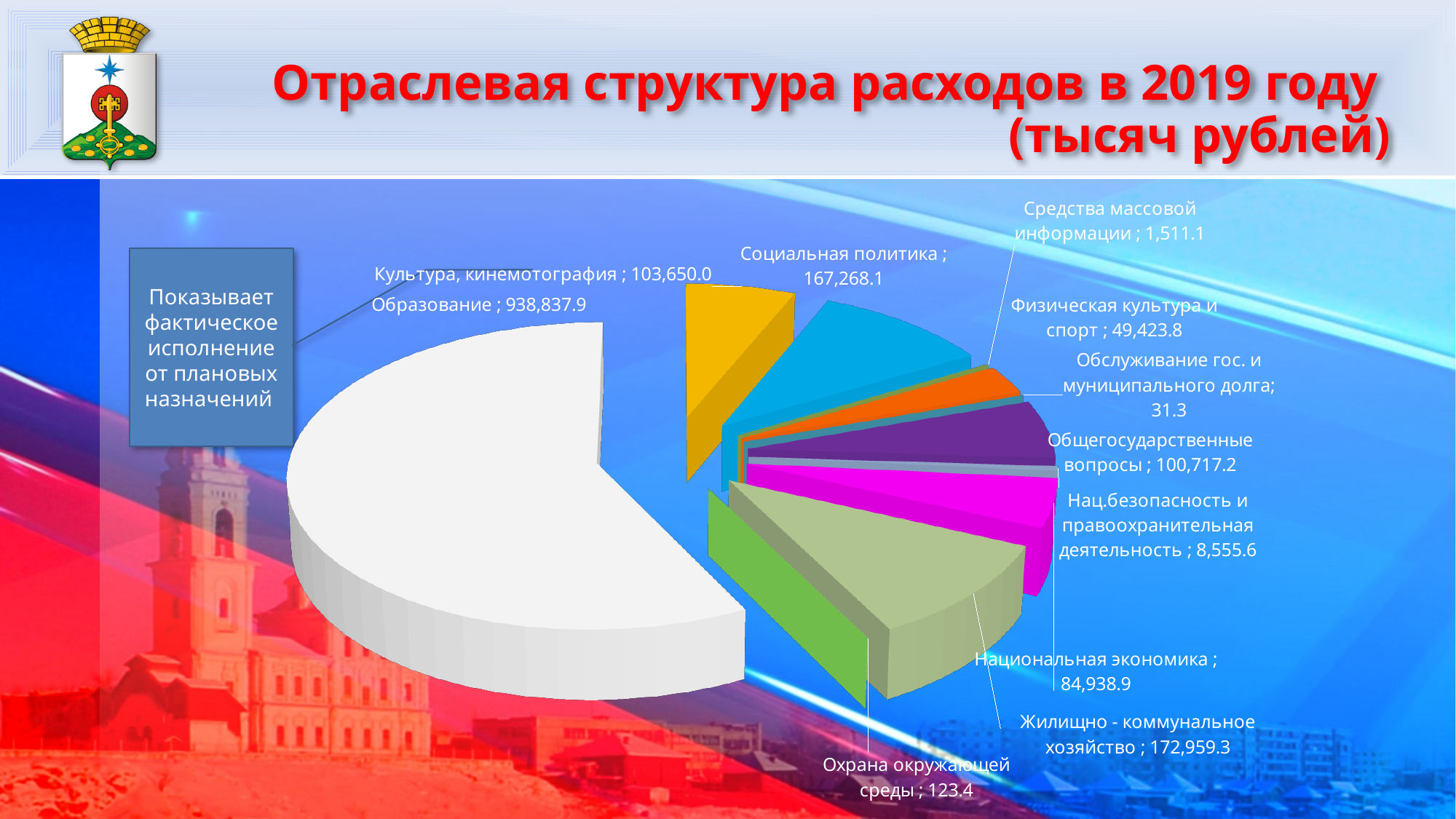
Which category has the highest value? Образование Which is larger: Национальная экономика or Физическая культура и спорт? Национальная экономика What is the title of the slide? Отраслевая структура расходов в 2019 году (тысяч рублей) What is the difference between Жилищно - коммунальное хозяйство and Социальная политика? 5,691.2 What is the value for Жилищно - коммунальное хозяйство? 172,959.3 What is the value for Образование? 938,837.9 What is the difference between Культура, кинемотография and Общегосударственные вопросы? 2,932.8 What type of chart is shown on the slide? Pie chart Which category has the lowest value? Обслуживание гос. и муниципального долга What is the value for Обслуживание гос. и муниципального долга? 31.3 How many categories are shown in the pie chart? 11 What is the value for Средства массовой информации? 1,511.1